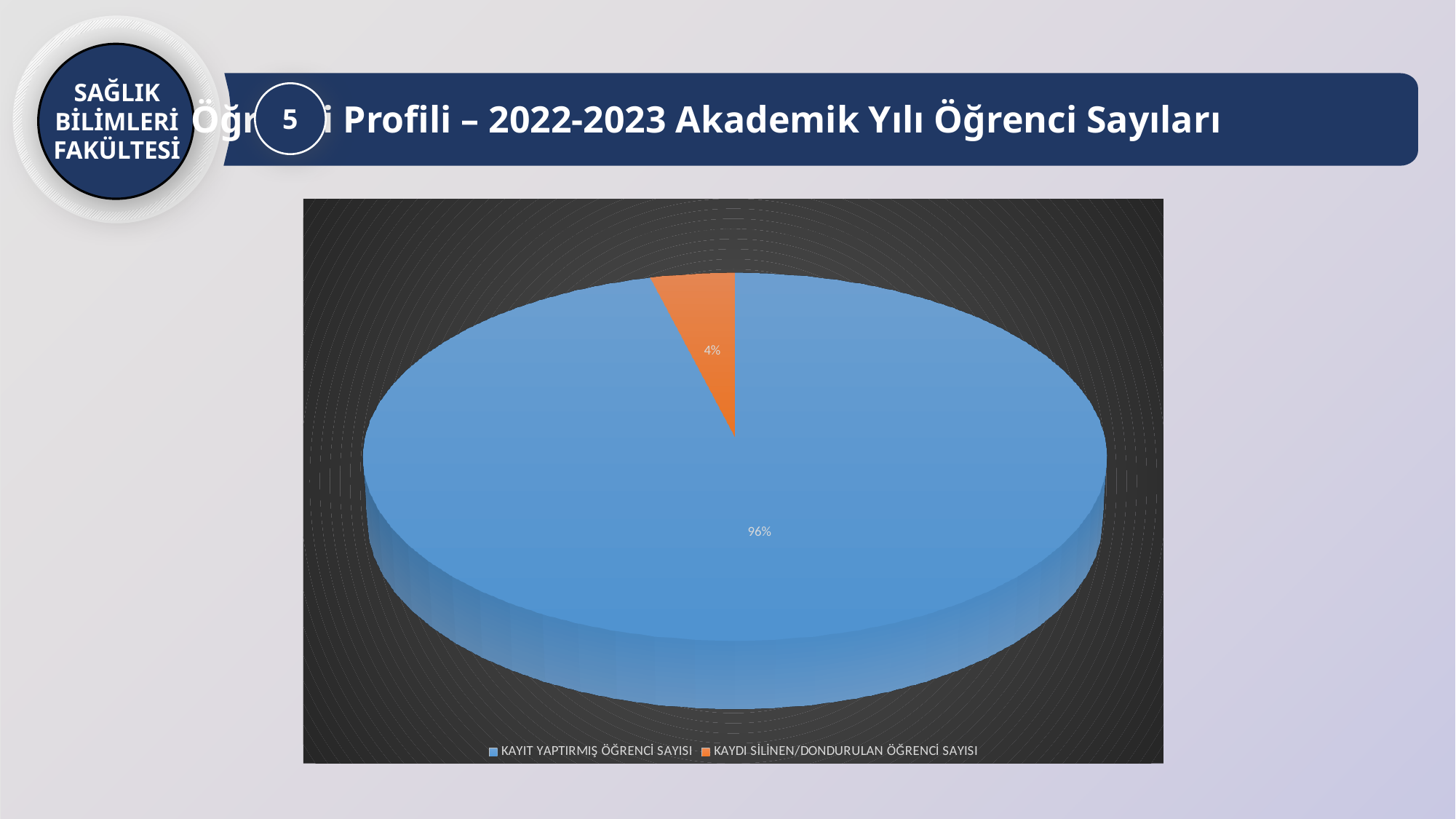
How many slices does the pie chart have? 2 What share of the pie does KAYIT YAPTIRMIŞ ÖĞRENCİ SAYISI take? 96% What colour is the KAYIT YAPTIRMIŞ ÖĞRENCİ SAYISI slice? Blue Which category has the smallest slice of the pie? KAYDI SİLİNEN/DONDURULAN ÖĞRENCİ SAYISI Which is larger, the KAYIT YAPTIRMIŞ ÖĞRENCİ SAYISI slice or the KAYDI SİLİNEN/DONDURULAN ÖĞRENCİ SAYISI slice? KAYIT YAPTIRMIŞ ÖĞRENCİ SAYISI What share of the pie does KAYDI SİLİNEN/DONDURULAN ÖĞRENCİ SAYISI take? 4% Which category has the largest slice of the pie? KAYIT YAPTIRMIŞ ÖĞRENCİ SAYISI What colour is the KAYDI SİLİNEN/DONDURULAN ÖĞRENCİ SAYISI slice? Orange What is the difference in percentage points between the KAYIT YAPTIRMIŞ ÖĞRENCİ SAYISI slice and the KAYDI SİLİNEN/DONDURULAN ÖĞRENCİ SAYISI slice? 92 percentage points How many entries does the legend list? 2 What kind of chart is shown on the slide? Pie chart